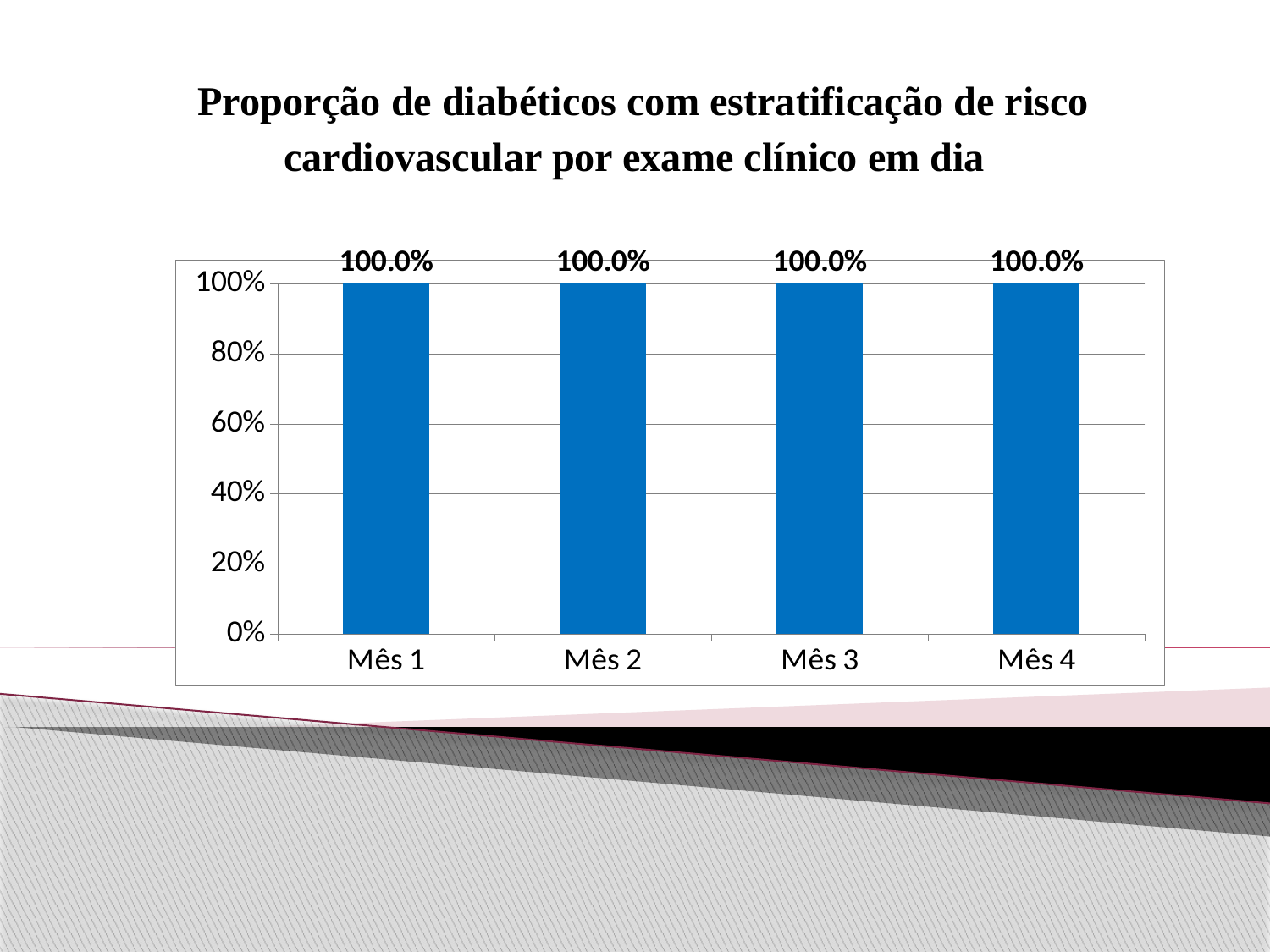
How many categories are shown on the x axis? 4 What is the value for Mês 1? 100.0% What is the value for Mês 4? 100.0% Is the value for Mês 3 greater or less than 60%? greater Is the value for Mês 2 greater or less than 80%? greater What kind of chart is shown on the slide? Bar chart What is the title of the chart? Proporção de diabéticos com estratificação de risco cardiovascular por exame clínico em dia What colour are the bars in the chart? Blue What is the difference between the values for Mês 1 and Mês 4? 0.0% Do the values rise, fall or stay the same from Mês 1 to Mês 4? Stay the same What is the value for Mês 3? 100.0% What is the value for Mês 2? 100.0%